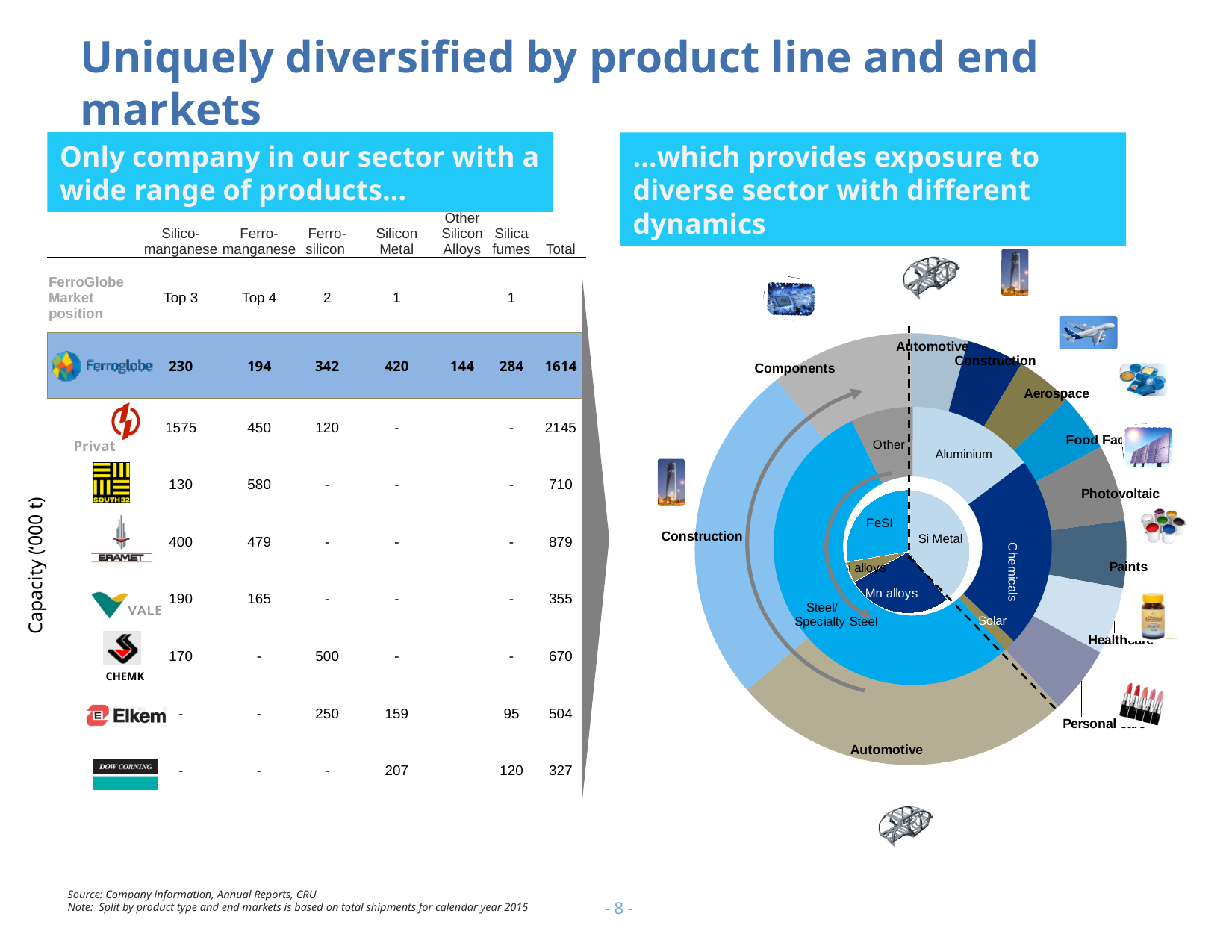
In the capacity table on the left, what is the difference between Ferroglobe's total capacity and Eramet's total capacity? 735 In the capacity table on the left, which company has the highest total capacity? Privat In the capacity table on the left, what is Ferroglobe's market position in Silicon Metal? 1 In the capacity table on the left, what is Ferroglobe's total capacity ('000 t)? 1614 In the capacity table on the left, what is Privat's Silico-manganese capacity? 1575 In the doughnut chart on the right, which end-market label appears at the bottom of the outer ring? Automotive In the capacity table on the left, what is Ferroglobe's Silicon Metal capacity? 420 In the capacity table on the left, what is Elkem's Silica fumes capacity? 95 In the doughnut chart on the right, which product segment in the innermost ring is labelled next to 'FeSi'? Si Metal In the capacity table on the left, which is larger: South32's Ferro-manganese capacity or Eramet's Ferro-manganese capacity? South32 What kind of chart is shown on the right side of the slide? doughnut chart In the capacity table on the left, which company has the lowest total capacity? Dow Corning